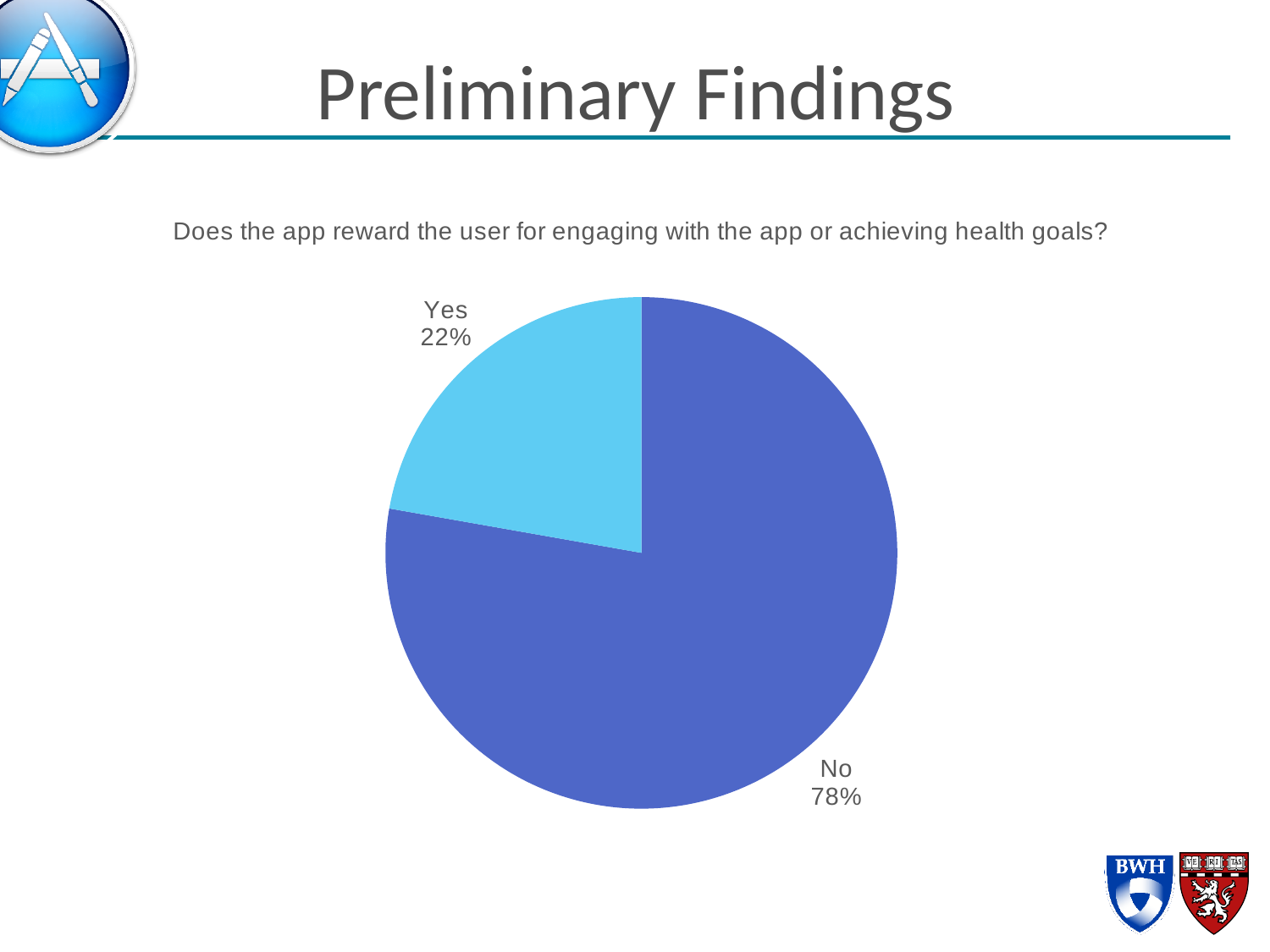
Which is larger, the "Yes" slice or the "No" slice? No What percentage of apps answered "Yes" to rewarding the user? 22% How many slices does the pie chart have? 2 What colour is the "Yes" slice of the pie? light blue What percentage of apps answered "No" to rewarding the user? 78% What question does the pie chart answer? Does the app reward the user for engaging with the app or achieving health goals? Which slice of the pie is the largest? No What is the difference in percentage points between the "No" and "Yes" slices? 56 What kind of chart is shown on the slide? pie chart What share of the pie does the "Yes" slice represent? 22% Which slice of the pie is the smallest? Yes